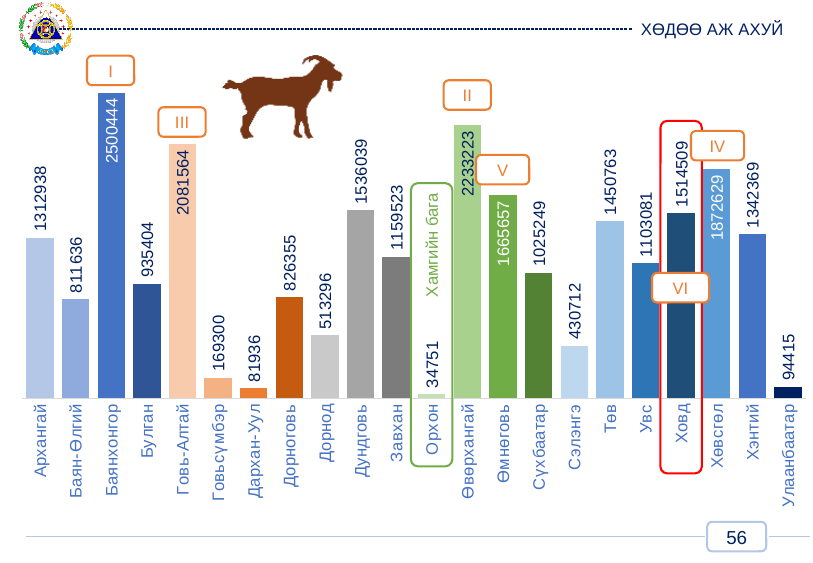
Which category is marked with the rank label "I"? Баянхонгор What is the value shown for Дархан-Уул? 81936 What is the value shown for Баянхонгор? 2500444 What is the difference between the values for Баянхонгор and Өвөрхангай? 267221 What is the value shown for Хөвсгөл? 1872629 What kind of chart is shown on the slide? Bar chart Which has a larger value, Говь-Алтай or Өвөрхангай? Өвөрхангай What is the value shown for Орхон? 34751 Which category has the lowest value? Орхон Which category has the highest value? Баянхонгор What is the difference between the values for Хөвсгөл and Ховд? 358120 How many categories are shown on the chart? 22